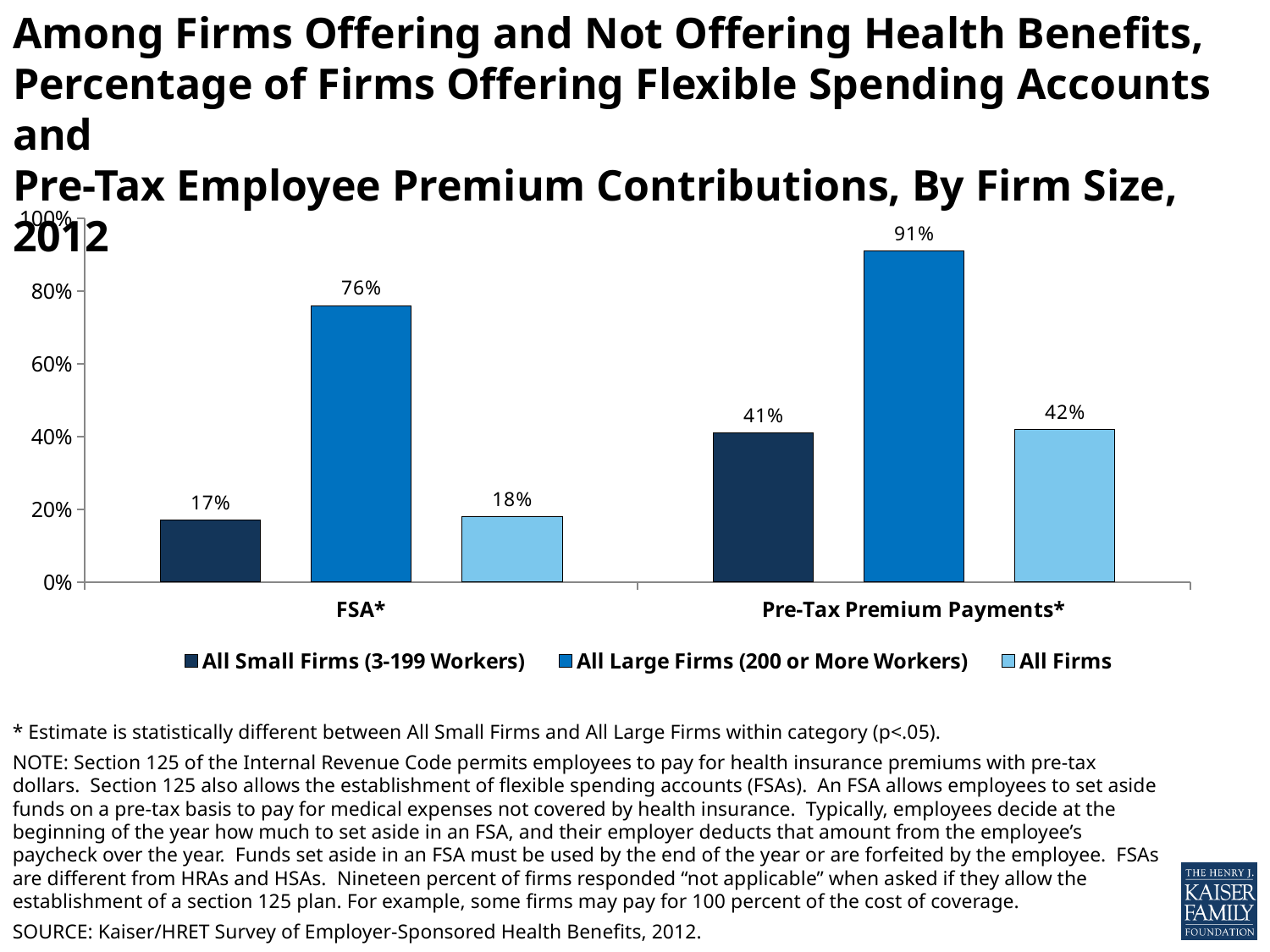
Which is larger: the All Firms value for FSA* or the All Firms value for Pre-Tax Premium Payments*? Pre-Tax Premium Payments* What is the difference between All Large Firms and All Firms in the Pre-Tax Premium Payments* category? 49 percentage points What kind of chart is shown on the slide? Bar chart Which series has the lowest value in the FSA* category? All Small Firms (3-199 Workers) Which series has the highest value in the Pre-Tax Premium Payments* category? All Large Firms (200 or More Workers) How many categories are shown on the x axis? 2 What is the value for All Firms in the FSA* category? 18% What percentage of All Small Firms (3-199 Workers) offer an FSA? 17% How many series does the legend list? 3 What is the value for All Small Firms (3-199 Workers) in the Pre-Tax Premium Payments* category? 41% What is the difference between All Large Firms and All Small Firms in the FSA* category? 59 percentage points What percentage of All Large Firms (200 or More Workers) offer Pre-Tax Premium Payments? 91%